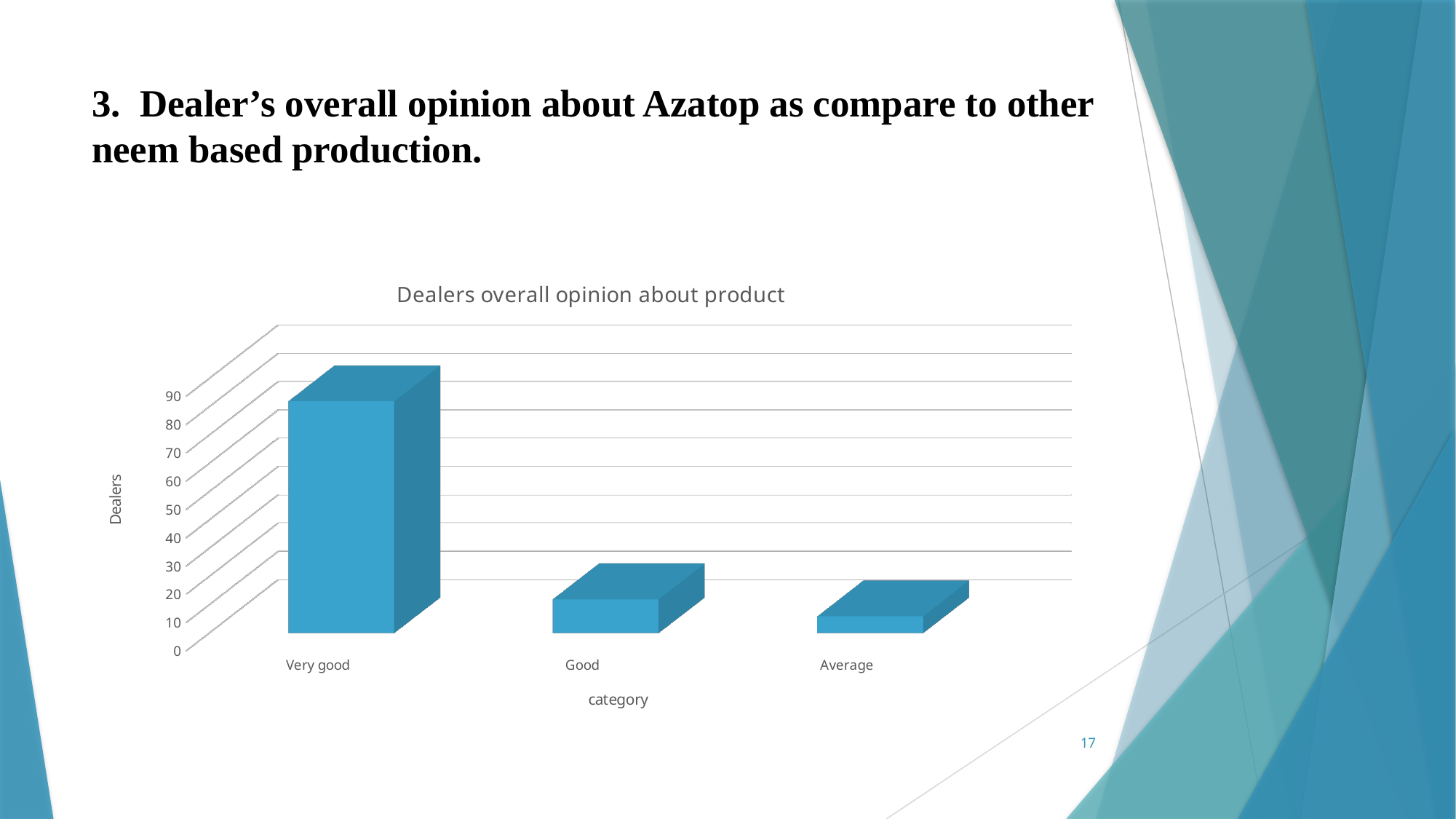
Is the value for Good greater or less than 30? less Is the value for Very good greater or less than 50? greater Which category has the lowest value in the chart? Average Do the values rise or fall moving from Very good to Average along the x axis? fall What type of chart is shown on the slide? bar chart Which category has the highest value in the chart? Very good Is the value for Average greater or less than 20? less What is the title of the chart? Dealers overall opinion about product Which is larger, the value for Very good or the value for Good? Very good How many categories are shown on the x axis of the chart? 3 What is the label of the vertical axis of the chart? Dealers